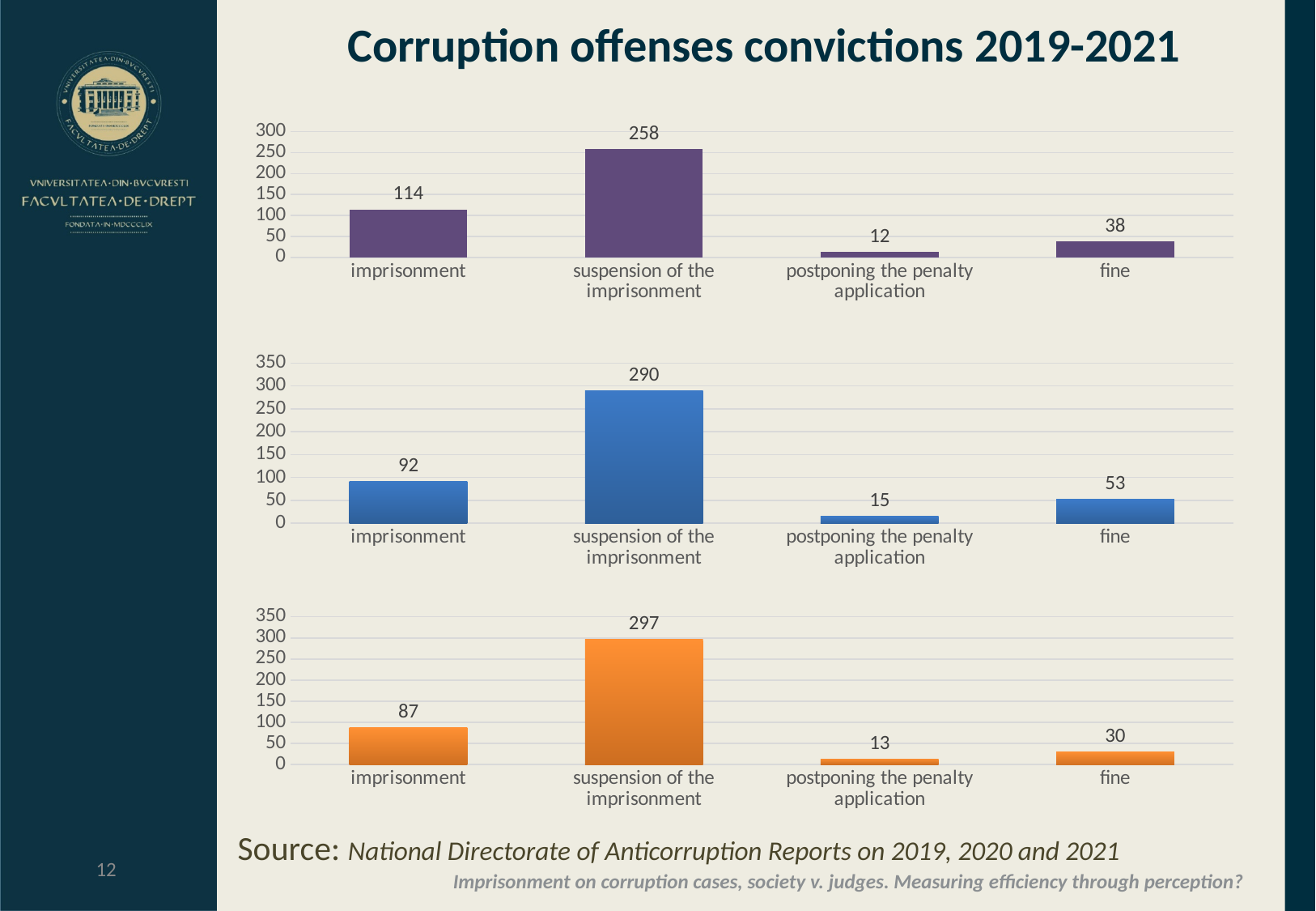
In the bottom chart, which is larger, imprisonment or fine? imprisonment How many charts are shown on the slide? 3 In the top chart, what is the difference between imprisonment and fine? 76 In the middle chart, what is the difference between suspension of the imprisonment and imprisonment? 198 What kind of chart is the middle chart? bar chart In the bottom chart, what is the value for fine? 30 How many categories are shown in the bottom chart? 4 In the middle chart, is the value for fine greater or less than 100? less In the middle chart, what is the value for imprisonment? 92 In the top chart, which category has the lowest value? postponing the penalty application In the bottom chart, which category has the highest value? suspension of the imprisonment In the top chart, what is the value for suspension of the imprisonment? 258